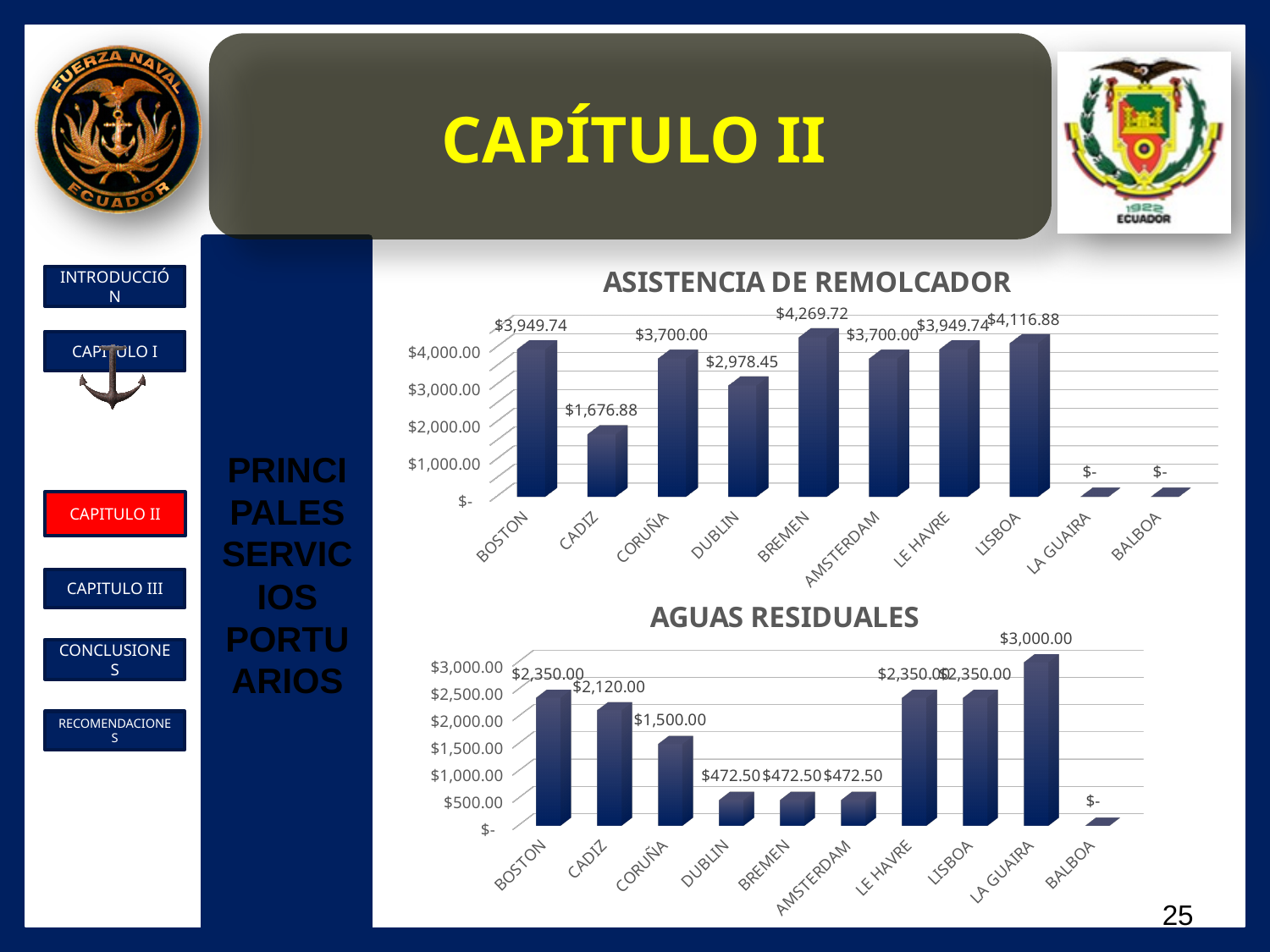
In the AGUAS RESIDUALES chart, what is the difference between the values for LA GUAIRA and CORUÑA? $1,500.00 In the AGUAS RESIDUALES chart, which port has the highest value? LA GUAIRA In the ASISTENCIA DE REMOLCADOR chart, what is the value for BREMEN? $4,269.72 In the ASISTENCIA DE REMOLCADOR chart, what is the difference between the values for BREMEN and CADIZ? $2,592.84 In the ASISTENCIA DE REMOLCADOR chart, what is the value for CADIZ? $1,676.88 In the AGUAS RESIDUALES chart, which is larger, the value for CADIZ or the value for CORUÑA? CADIZ What type of chart is the AGUAS RESIDUALES chart? Bar chart In the ASISTENCIA DE REMOLCADOR chart, which is larger, the value for LISBOA or the value for DUBLIN? LISBOA In the AGUAS RESIDUALES chart, what is the value for LA GUAIRA? $3,000.00 In the AGUAS RESIDUALES chart, what is the value for DUBLIN? $472.50 In the ASISTENCIA DE REMOLCADOR chart, which port has the highest value? BREMEN How many ports are shown in the ASISTENCIA DE REMOLCADOR chart? 10